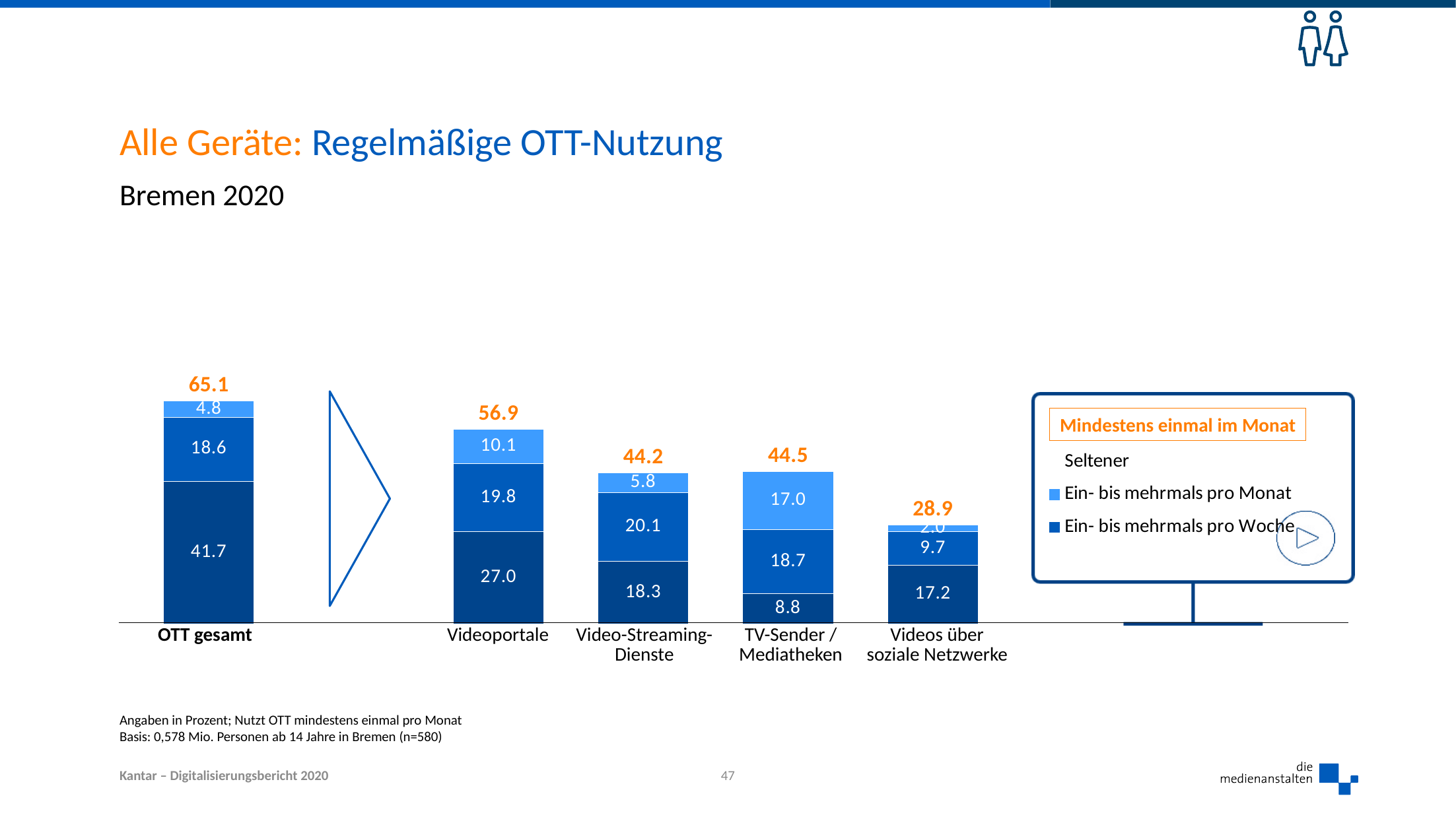
What is the total value shown above the bar for OTT gesamt? 65.1 Which category has the highest total value? OTT gesamt How many categories are shown on the x axis? 5 What kind of chart is shown on the slide? Stacked bar chart Which region and year does the subtitle of the chart refer to? Bremen 2020 What is the 'Ein- bis mehrmals pro Woche' value for Videoportale? 19.8 Which is larger: the 'Ein- bis mehrmals pro Woche' value for Video-Streaming-Dienste or for TV-Sender / Mediatheken? Video-Streaming-Dienste What is the difference between the total for Videoportale and the total for Videos über soziale Netzwerke? 28.0 What is the 'Ein- bis mehrmals pro Monat' value for Video-Streaming-Dienste? 5.8 Which category has the lowest total value? Videos über soziale Netzwerke